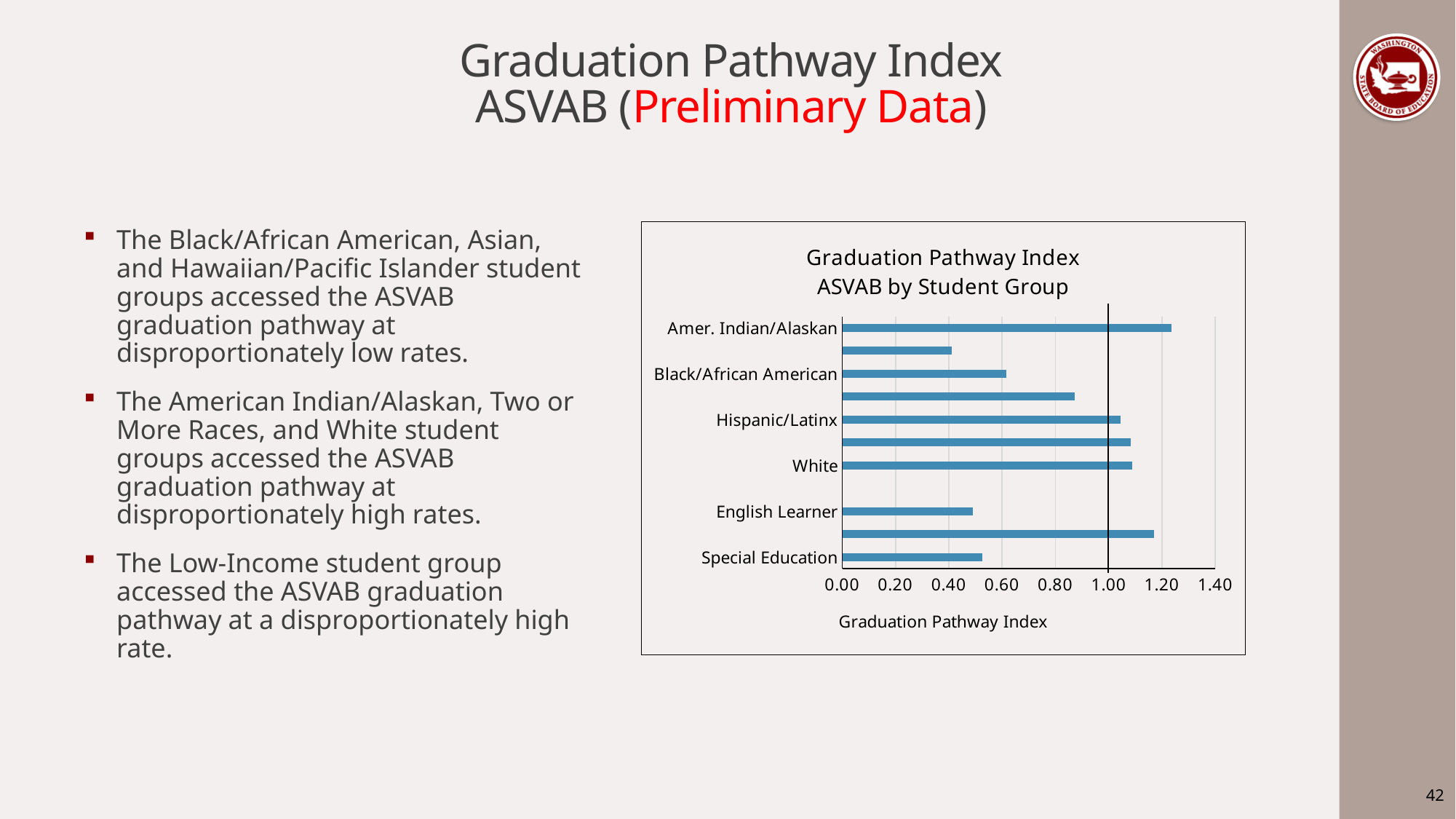
Which has the larger value, White or English Learner? White What is the label on the x axis of the chart? Graduation Pathway Index What kind of chart is shown on the slide? Bar chart Is the value for Black/African American greater or less than 0.80? less Is the value for Special Education greater or less than 0.60? less Is the value for Hispanic/Latinx greater or less than 0.80? greater What is the title of the chart? Graduation Pathway Index ASVAB by Student Group Which has the larger value, Amer. Indian/Alaskan or Black/African American? Amer. Indian/Alaskan Which student group has the longest bar in the chart? Amer. Indian/Alaskan